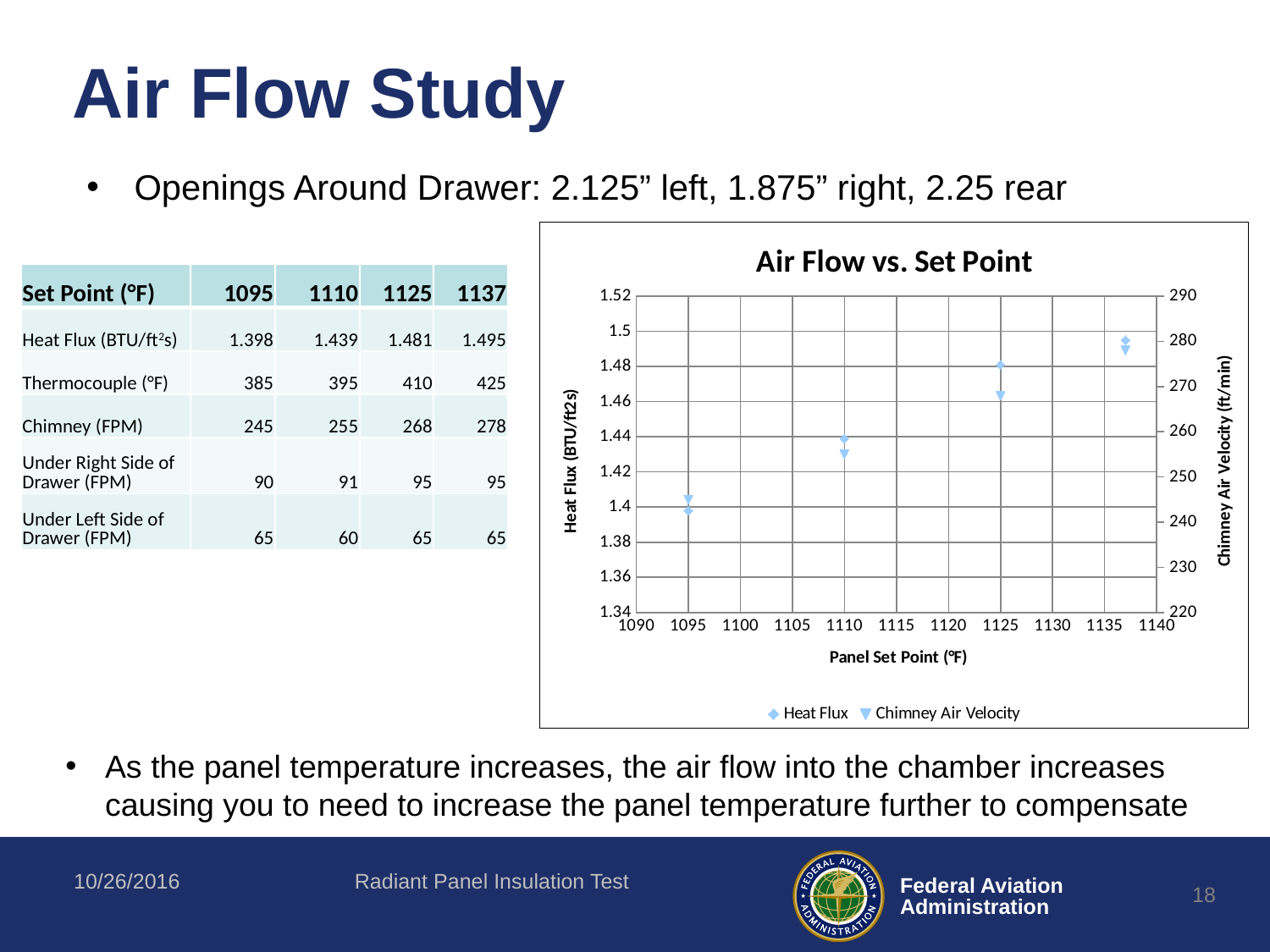
Is the Heat Flux value at a set point of 1110 greater or less than 1.46? less Is the Chimney Air Velocity at a set point of 1137 greater or less than 270? greater How many data points are plotted for the Heat Flux series? 4 Is the Heat Flux value at a set point of 1125 greater or less than 1.46? greater Does Heat Flux rise or fall as the Panel Set Point increases? rise What is the label of the chart's x axis? Panel Set Point (°F) How many series does the chart legend list? 2 What kind of chart is shown on the slide? scatter chart What is the title of the chart? Air Flow vs. Set Point Does Chimney Air Velocity rise or fall as the Panel Set Point increases? rise